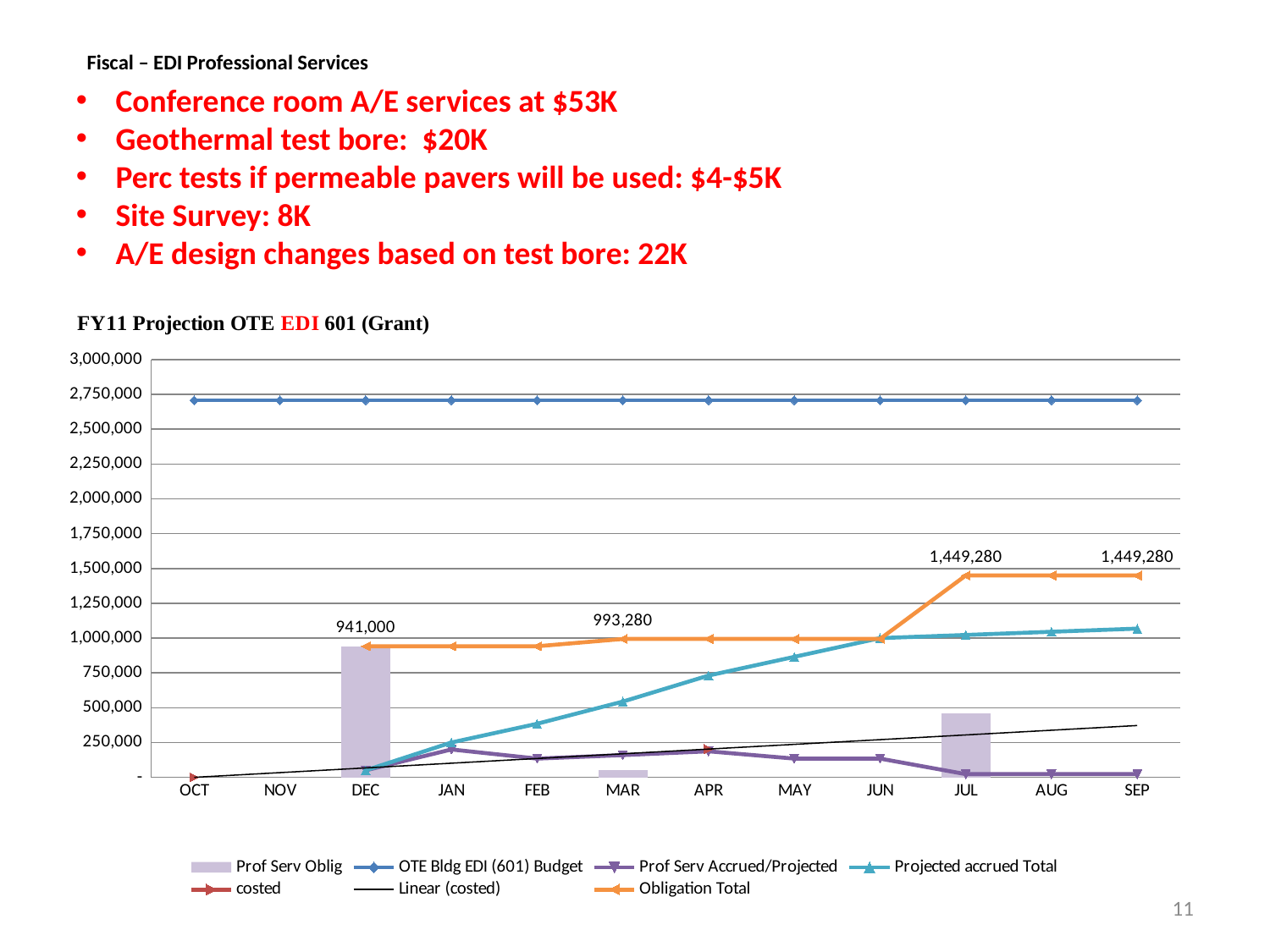
In the FY11 Projection OTE EDI 601 (Grant) chart, is the OTE Bldg EDI (601) Budget value at OCT greater or less than 2,500,000? greater In the FY11 Projection OTE EDI 601 (Grant) chart, what is the Obligation Total value labelled at MAR? 993,280 In the FY11 Projection OTE EDI 601 (Grant) chart, is the Projected accrued Total value at FEB greater or less than 500,000? less In the FY11 Projection OTE EDI 601 (Grant) chart, what is the difference between the Obligation Total labelled at MAR and the one labelled at DEC? 52,280 In the FY11 Projection OTE EDI 601 (Grant) chart, what is the Obligation Total value labelled at JUL? 1,449,280 How many months are shown on the x axis of the FY11 Projection OTE EDI 601 (Grant) chart? 12 In the FY11 Projection OTE EDI 601 (Grant) chart, what is the Obligation Total value labelled at DEC? 941,000 What kind of chart is the FY11 Projection OTE EDI 601 (Grant) chart? combined bar and line chart In the FY11 Projection OTE EDI 601 (Grant) chart, which is larger at SEP: the Obligation Total or the Projected accrued Total? Obligation Total How many series does the legend of the FY11 Projection OTE EDI 601 (Grant) chart list? 7 In the FY11 Projection OTE EDI 601 (Grant) chart, does the Projected accrued Total series rise or fall from DEC to SEP? rise In the FY11 Projection OTE EDI 601 (Grant) chart, what is the difference between the Obligation Total labelled at JUL and the one labelled at MAR? 456,000